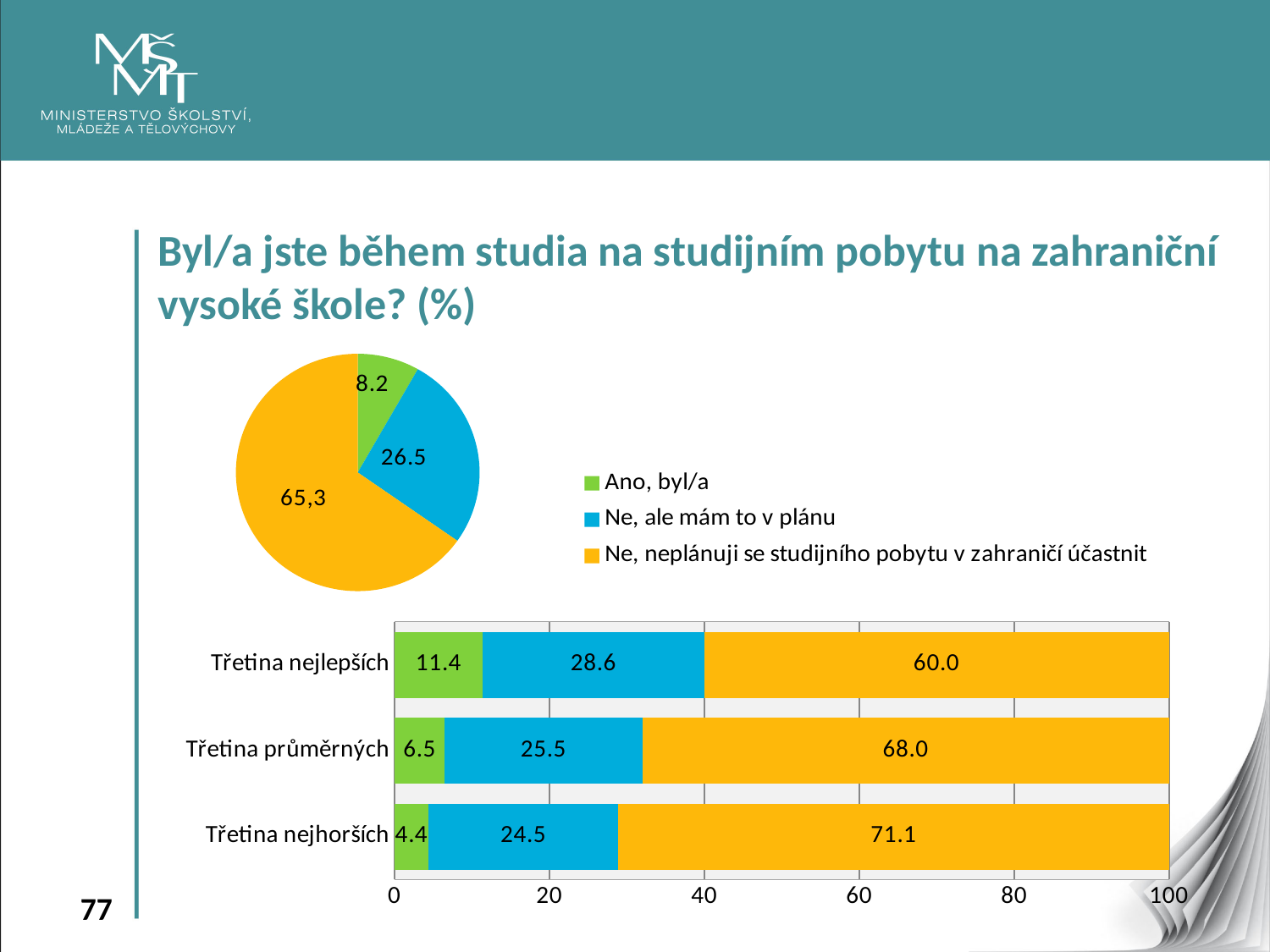
In the bar chart, what is the 'Ne, neplánuji se studijního pobytu v zahraničí účastnit' value for 'Třetina nejhorších'? 71.1 In the bar chart, which is larger: the 'Ne, ale mám to v plánu' value for 'Třetina nejlepších' or for 'Třetina nejhorších'? Třetina nejlepších How many categories are shown on the bar chart? 3 In the bar chart, what is the 'Ne, ale mám to v plánu' value for 'Třetina průměrných'? 25.5 In the pie chart, which category has the smallest slice? Ano, byl/a In the bar chart, what is the 'Ano, byl/a' value for 'Třetina nejlepších'? 11.4 In the pie chart, what is the value of the 'Ano, byl/a' slice? 8.2 In the bar chart, which category has the highest 'Ano, byl/a' value? Třetina nejlepších In the bar chart, what is the difference between the 'Ne, neplánuji se studijního pobytu v zahraničí účastnit' values for 'Třetina nejhorších' and 'Třetina nejlepších'? 11.1 What type of chart is the bottom chart on the slide? Stacked bar chart In the pie chart, what is the value of the 'Ne, ale mám to v plánu' slice? 26.5 In the pie chart, which category has the largest slice? Ne, neplánuji se studijního pobytu v zahraničí účastnit